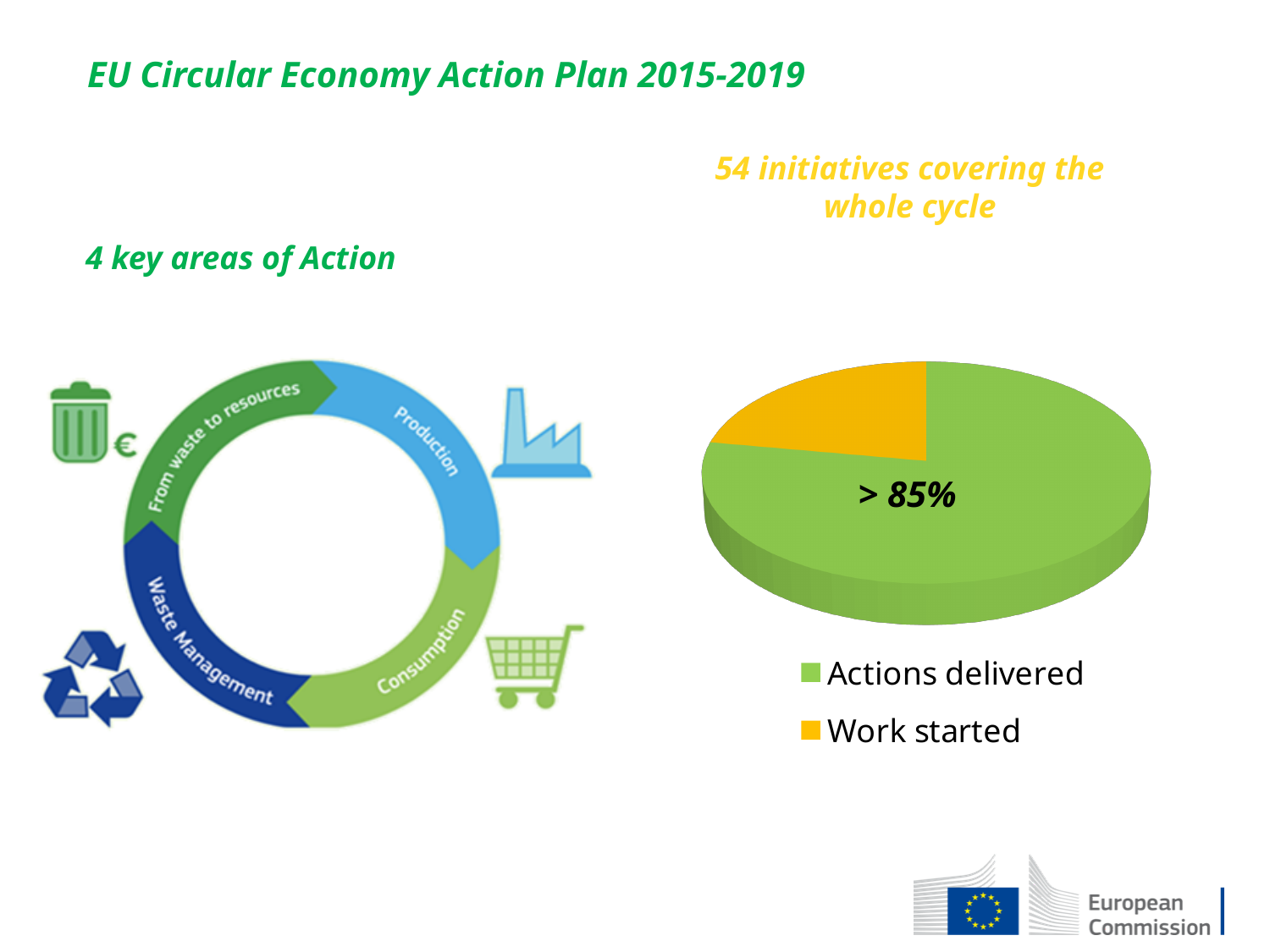
In the pie chart, which is larger: Actions delivered or Work started? Actions delivered How many entries does the legend of the pie chart list? 2 How many slices does the pie chart have? 2 What colour is the Work started slice in the pie chart? yellow What colour is the Actions delivered slice in the pie chart? green Which slice of the pie chart is the smallest? Work started What label is printed on the Actions delivered slice of the pie chart? > 85% Which slice of the pie chart is the largest? Actions delivered What kind of chart is shown on the right side of the slide? pie chart According to the text above the pie chart, how many initiatives cover the whole cycle? 54